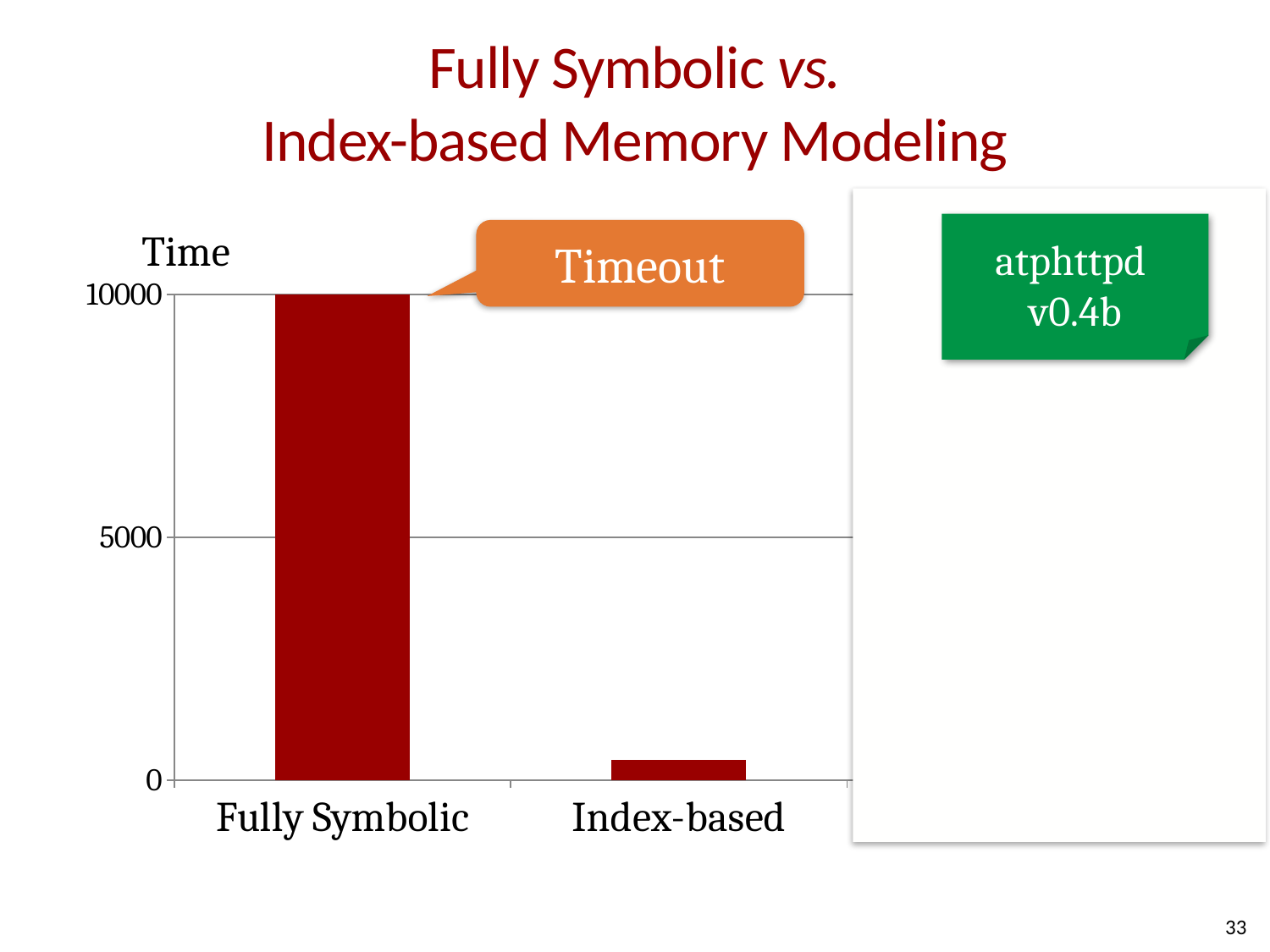
What is the label on the vertical axis? Time Is the value for Index-based greater or less than 5000? less Which category has the highest value? Fully Symbolic What does the callout attached to the Fully Symbolic bar say? Timeout Do the values fall or rise from Fully Symbolic to Index-based? fall What kind of chart is shown on the slide? bar chart Is the value for Fully Symbolic greater or less than 5000? greater Which has the larger value, Fully Symbolic or Index-based? Fully Symbolic What is the highest tick value shown on the vertical axis? 10000